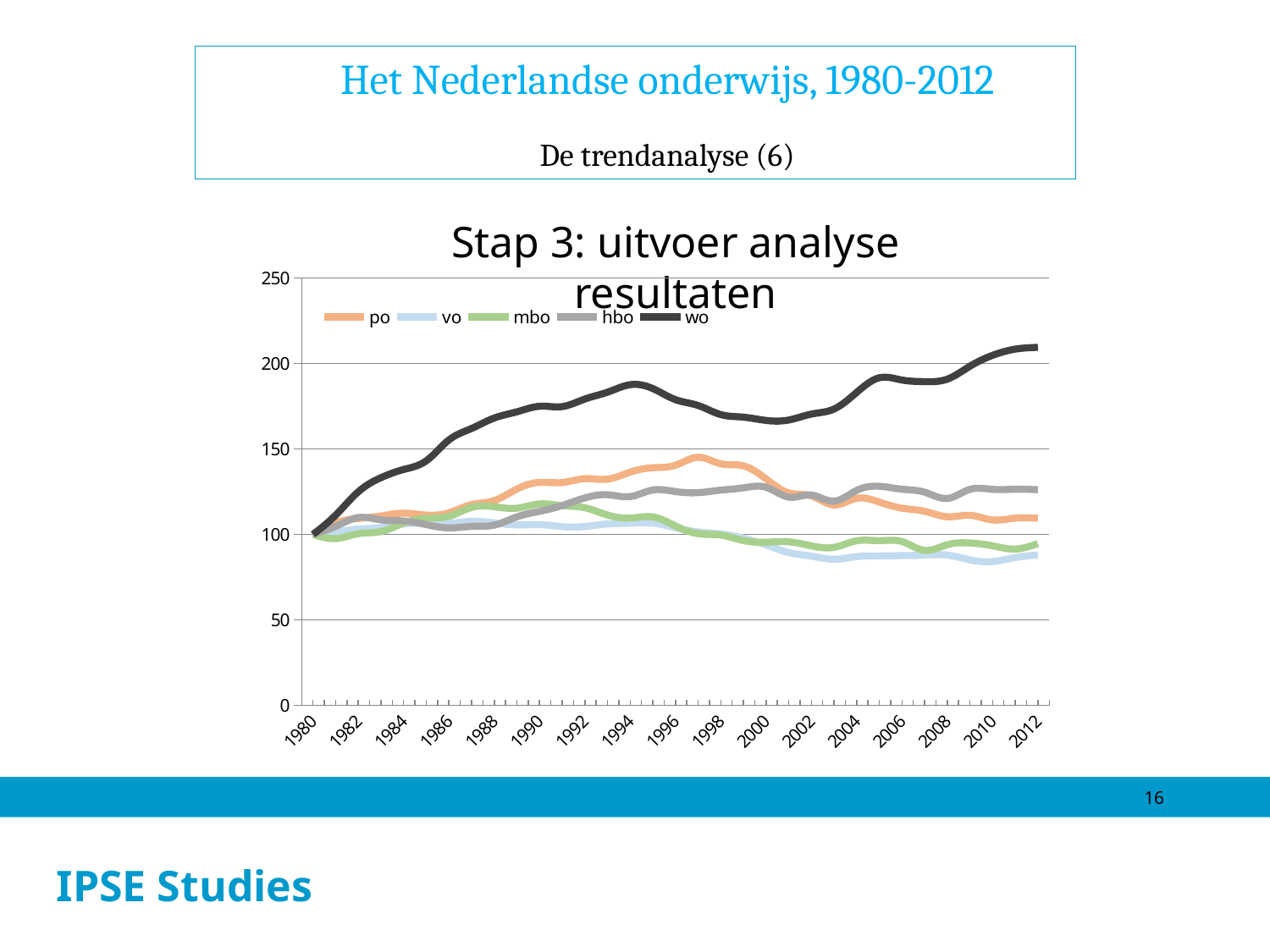
Is the value for wo in 2012 greater or less than 200? greater Which series has the lowest value in 2012? vo What kind of chart is shown on the slide? line chart How many series does the legend list? 5 Which series has the highest value in 2012? wo Is the value for wo in 1990 greater or less than 150? greater Which is larger in 2012, the value for hbo or the value for po? hbo Which series is drawn with the black line? wo Does the wo series rise or fall overall from 1980 to 2012? rise Is the value for po in 2012 greater or less than 150? less What is the title of the chart? Stap 3: uitvoer analyse resultaten